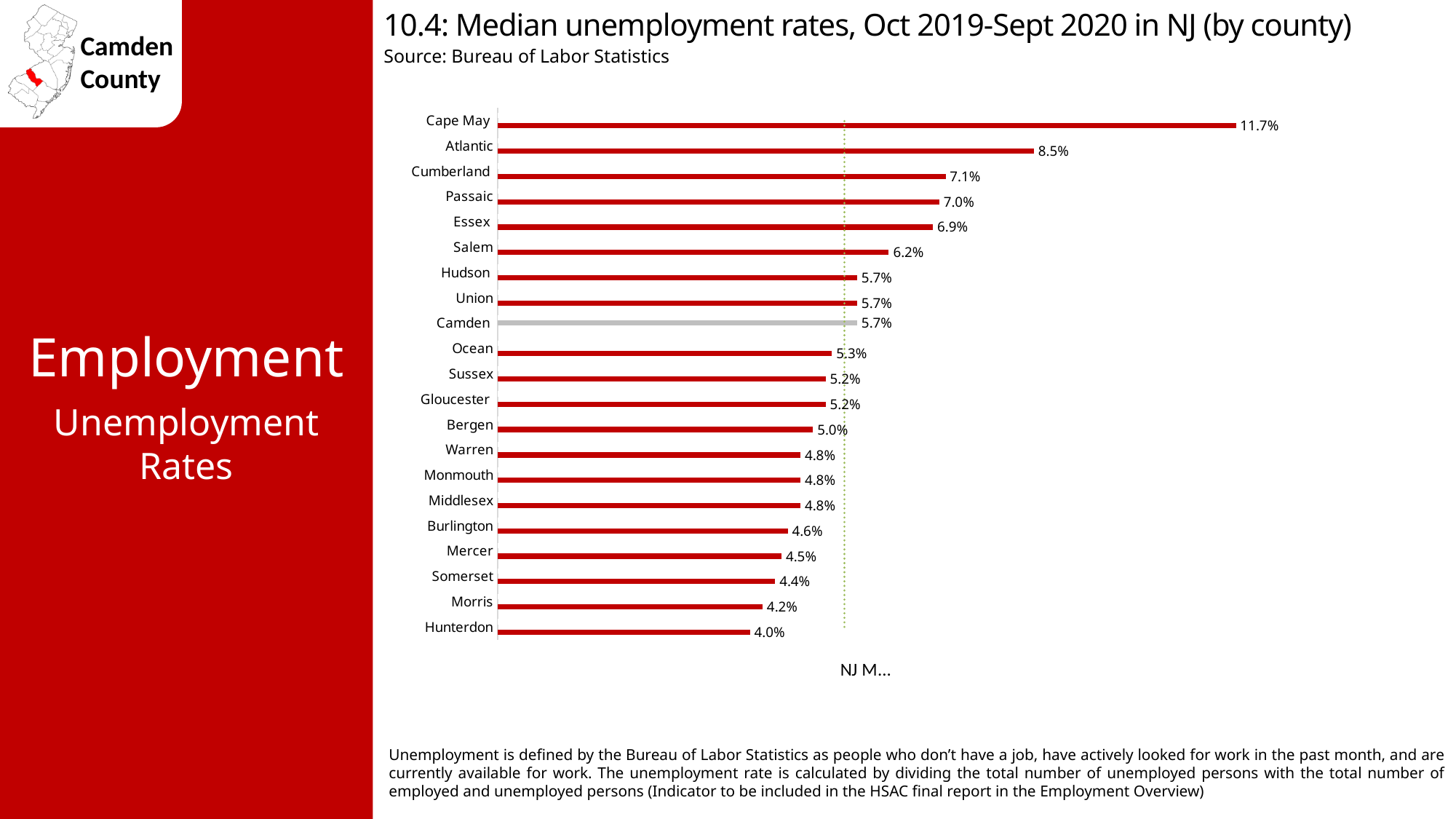
Which county has the lowest median unemployment rate? Hunterdon What is the difference between the median unemployment rates of Cape May and Atlantic? 3.2% What type of chart is used to show the median unemployment rates? Bar chart What is the difference between the median unemployment rates of Camden and Burlington? 1.1% Which county has the highest median unemployment rate? Cape May Which county's bar is shown in grey rather than red? Camden How many counties are shown in the chart? 21 Which county has a higher median unemployment rate, Salem or Ocean? Salem What is the median unemployment rate for Cape May? 11.7% What is the median unemployment rate for Camden County? 5.7% What is the median unemployment rate for Gloucester? 5.2% Which county has a higher median unemployment rate, Morris or Mercer? Mercer